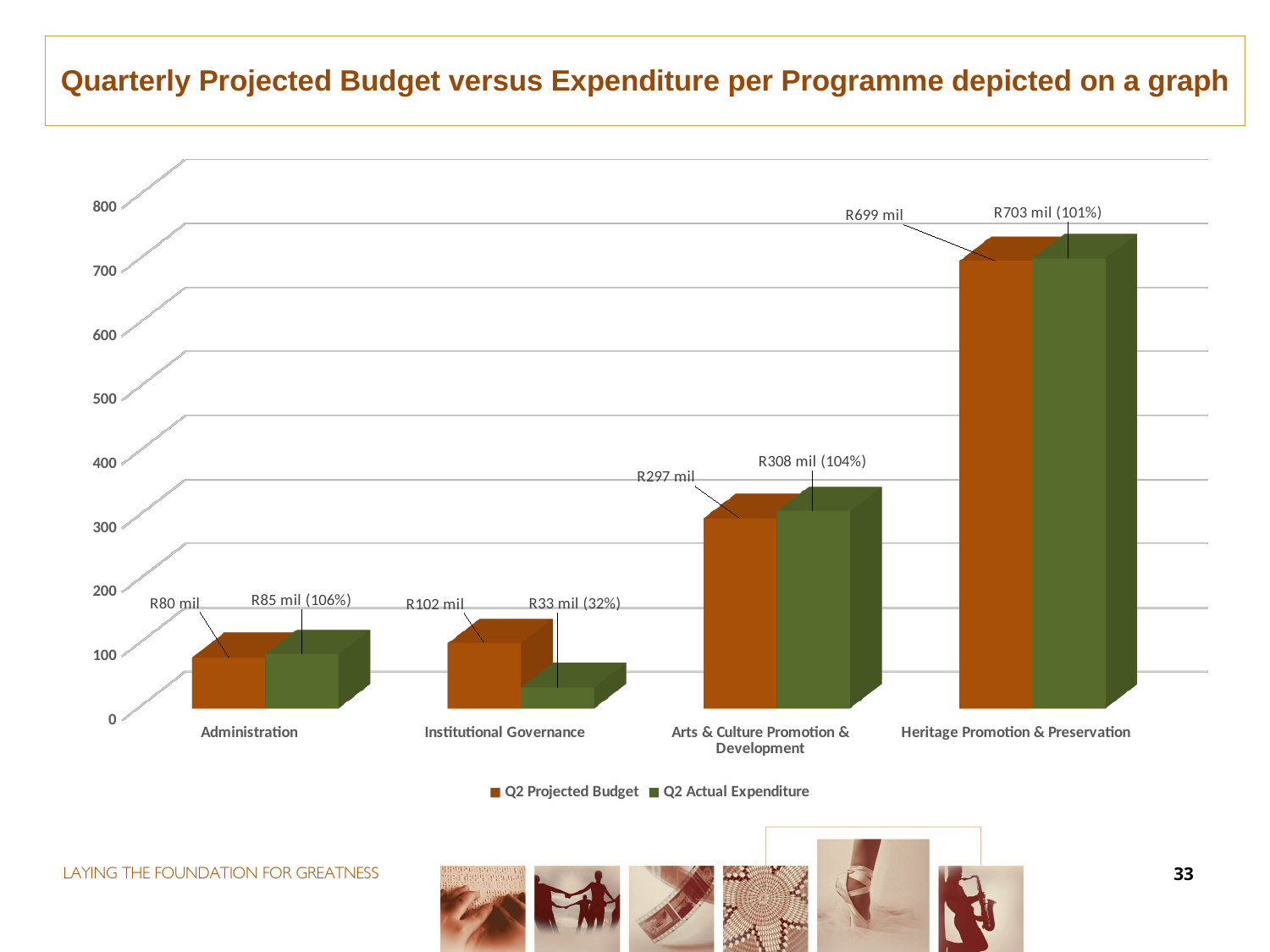
Which programme has the lowest Q2 Projected Budget? Administration What is the Q2 Actual Expenditure for Arts & Culture Promotion & Development? R308 mil (104%) Which series is shown in green in the legend? Q2 Actual Expenditure What is the Q2 Projected Budget for Heritage Promotion & Preservation? R699 mil What kind of chart is shown on the slide? Bar chart What is the Q2 Actual Expenditure for Institutional Governance? R33 mil (32%) What is the difference between the Q2 Projected Budget and Q2 Actual Expenditure for Institutional Governance? R69 mil How many programmes are shown on the x axis? 4 Which is larger for Administration: the Q2 Projected Budget or the Q2 Actual Expenditure? Q2 Actual Expenditure What is the Q2 Projected Budget for Administration? R80 mil How many series does the legend list? 2 Which programme has the highest Q2 Actual Expenditure? Heritage Promotion & Preservation